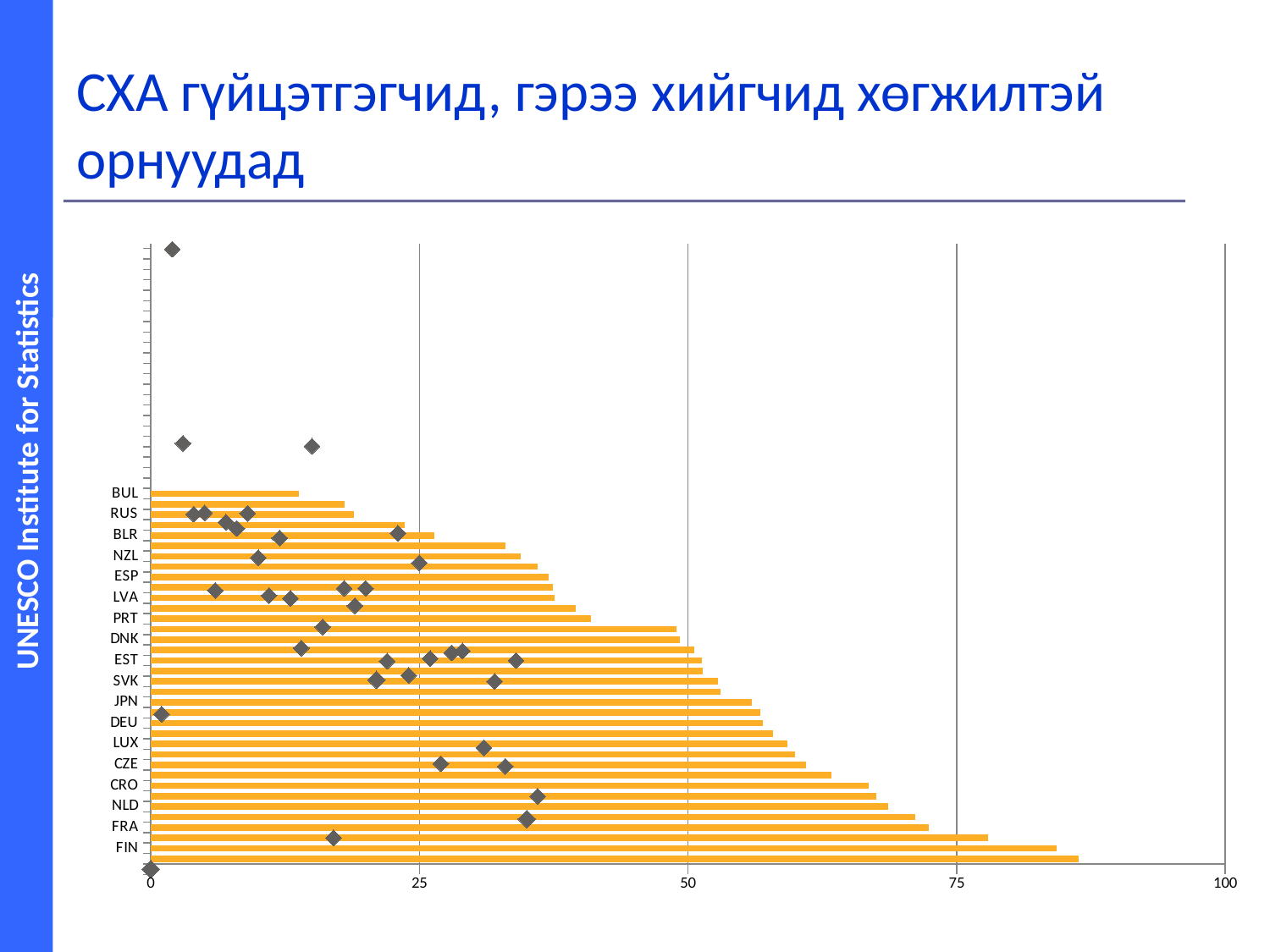
Do the bar lengths increase or decrease going from the top of the chart to the bottom? increase Is the bar value for CRO greater or less than 75? less Is the bar value for PRT greater or less than 50? less What is the highest value shown on the horizontal axis? 100 Which has the longer bar, FIN or BUL? FIN Is the bar value for FIN greater or less than 50? greater Which labelled category has the shortest bar? BUL What kind of chart is shown on the slide? bar chart